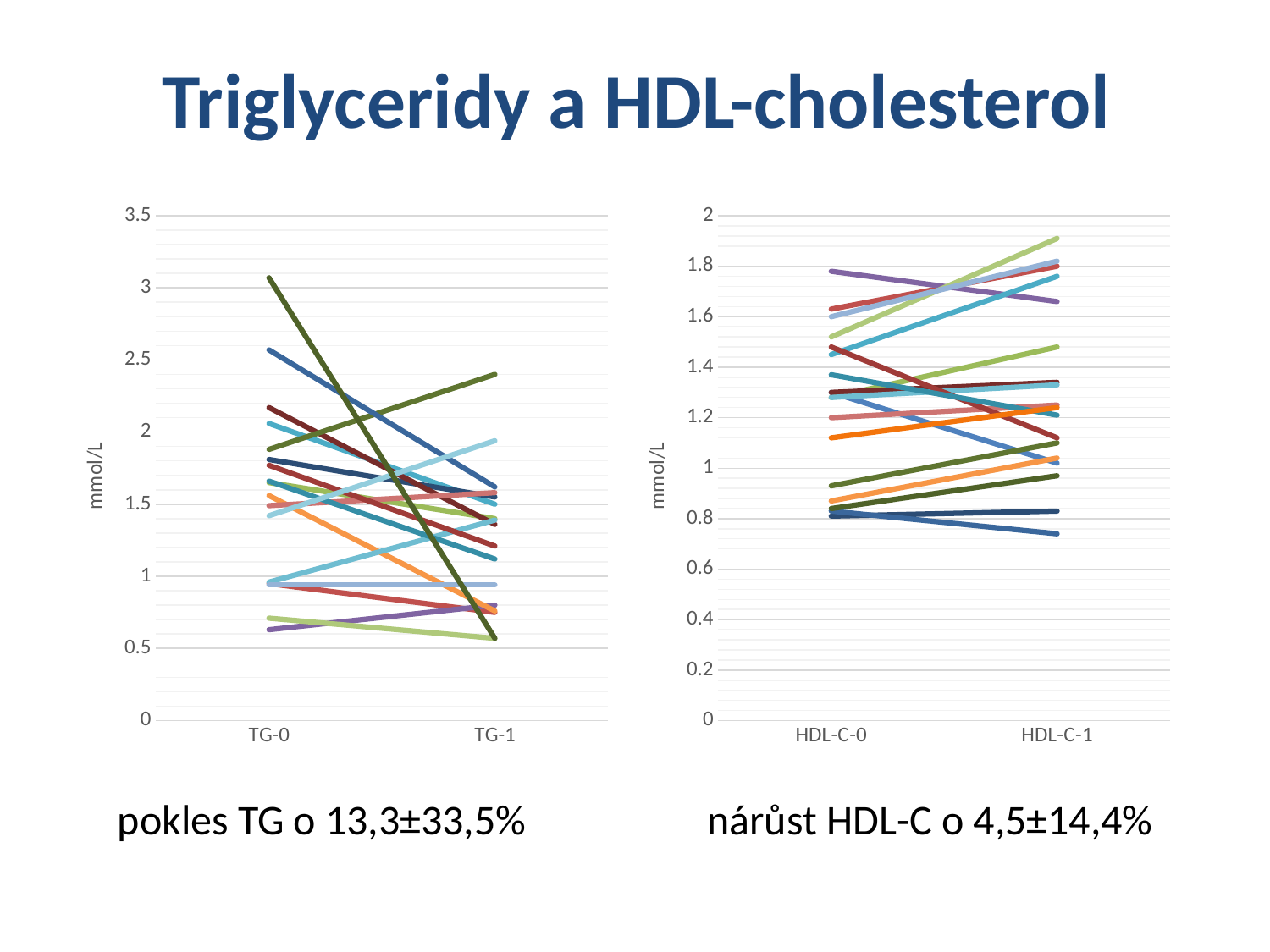
What kind of chart is the right chart (HDL-C-0 to HDL-C-1)? line chart In the right chart, how many categories are shown on the x axis? 2 In the left chart, what unit is shown on the y axis? mmol/L In the right chart, is the highest value at HDL-C-0 greater or less than 1.6? greater In the left chart, is the highest value at TG-0 greater or less than 2.5? greater In the left chart, is the lowest value at TG-1 greater or less than 1? less In the right chart, what are the two x-axis category labels? HDL-C-0 and HDL-C-1 In the left chart, how many categories are shown on the x axis? 2 What kind of chart is the left chart (TG-0 to TG-1)? line chart